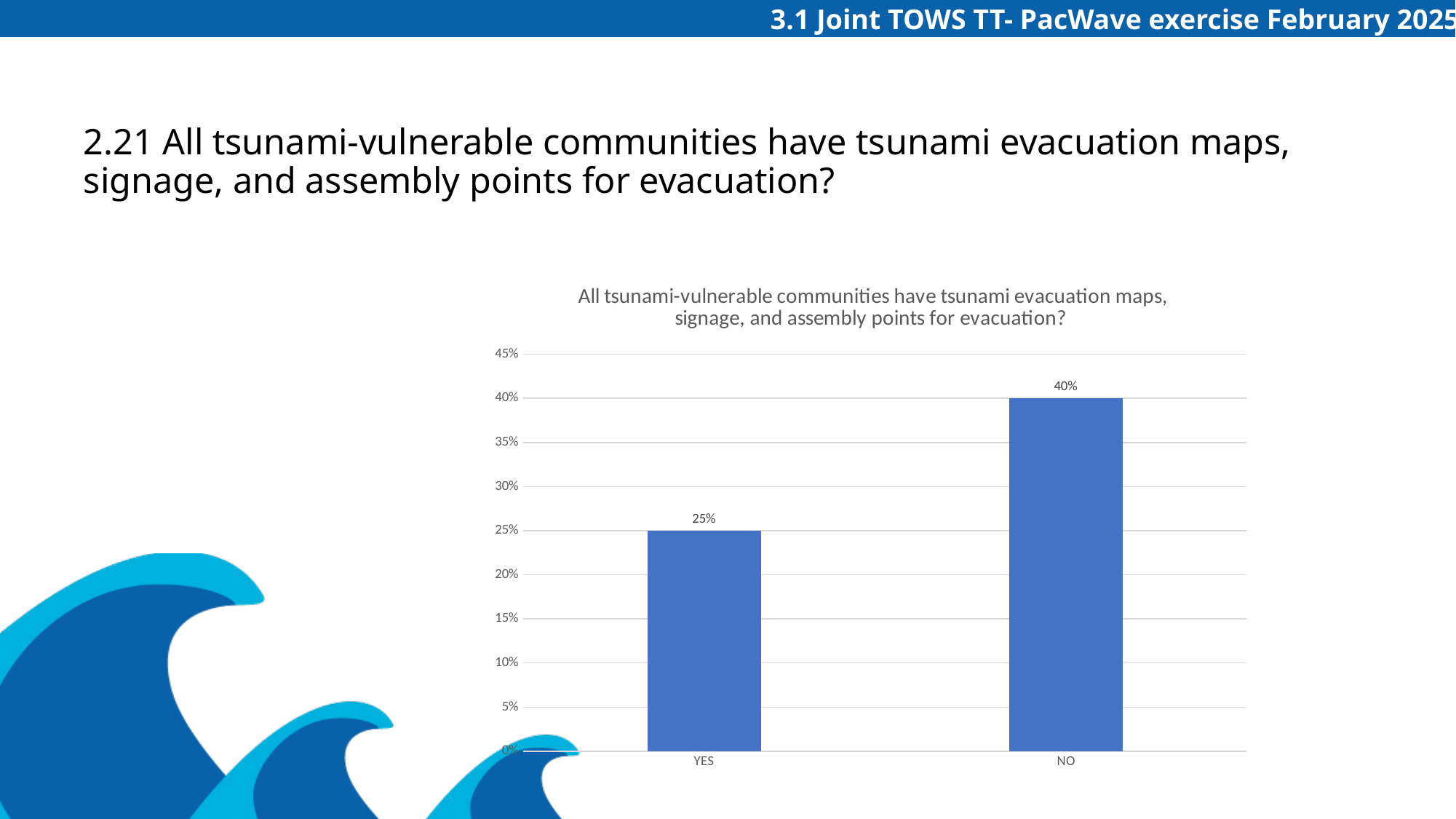
What is the difference between the values for NO and YES? 15% Is the value for NO greater or less than 35%? greater What is the value for YES? 25% Is the value for YES greater or less than 30%? less What is the highest value shown on the y axis? 45% What is the title of the chart? All tsunami-vulnerable communities have tsunami evacuation maps, signage, and assembly points for evacuation? Which is larger, the value for YES or the value for NO? NO What kind of chart is shown on the slide? bar chart What is the value for NO? 40% Which category has the lowest value? YES How many categories are shown on the x axis? 2 Which category has the highest value? NO